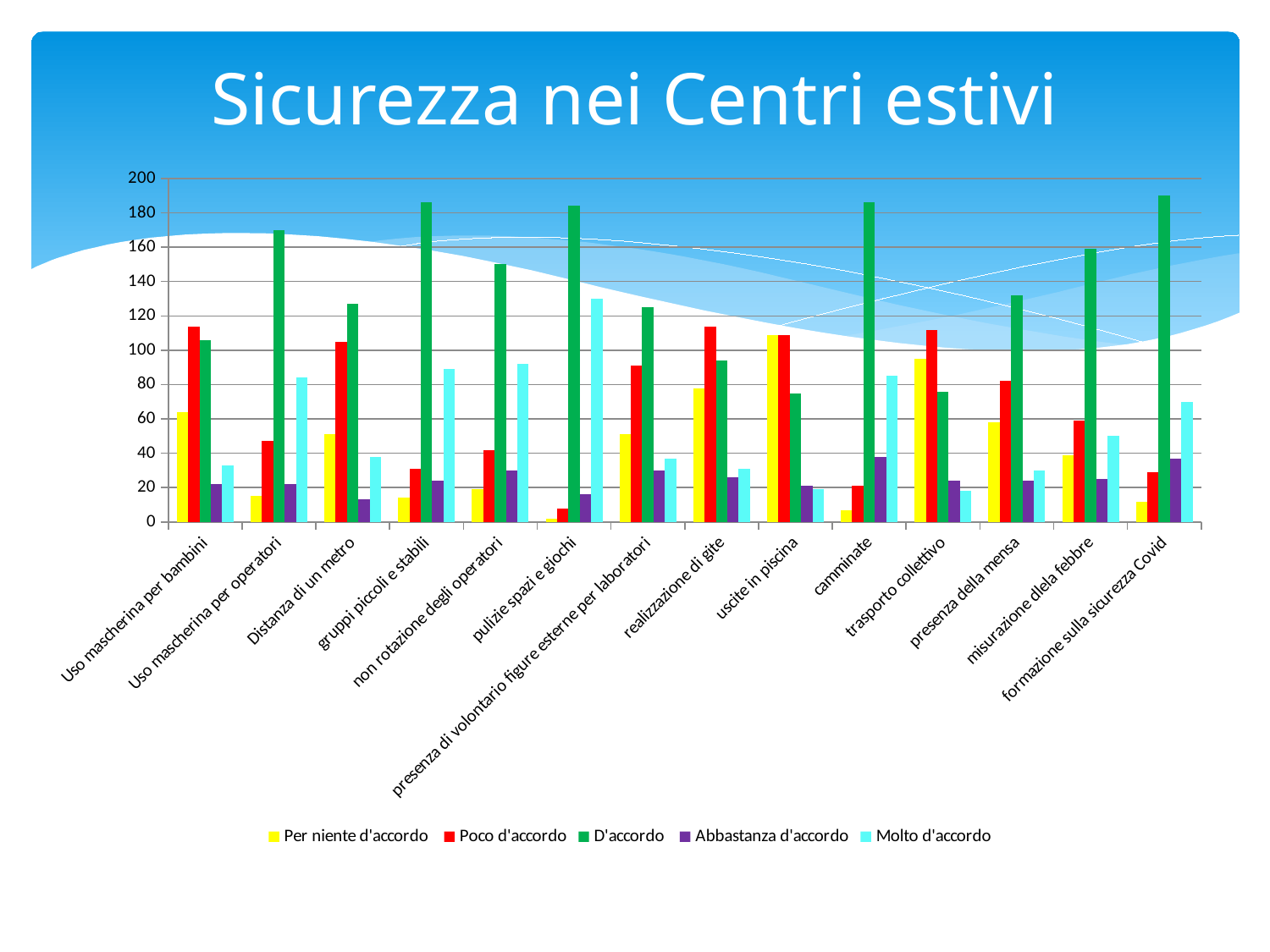
What is the title of the slide? Sicurezza nei Centri estivi Which category has the highest value for 'Molto d'accordo'? pulizie spazi e giochi For 'realizzazione di gite', which is larger: 'Poco d'accordo' or 'D'accordo'? Poco d'accordo Is the value for 'D'accordo' in 'non rotazione degli operatori' greater or less than 160? less Is the value for 'Per niente d'accordo' in 'camminate' greater or less than 20? less Which colour represents the series 'D'accordo' in the legend? green Is the value for 'D'accordo' in 'Uso mascherina per operatori' greater or less than 160? greater What kind of chart is shown on the slide? bar chart How many series does the legend list? 5 How many categories are shown on the x axis? 14 Which category has the highest value for 'Per niente d'accordo'? uscite in piscina Which category has the lowest value for 'Per niente d'accordo'? pulizie spazi e giochi